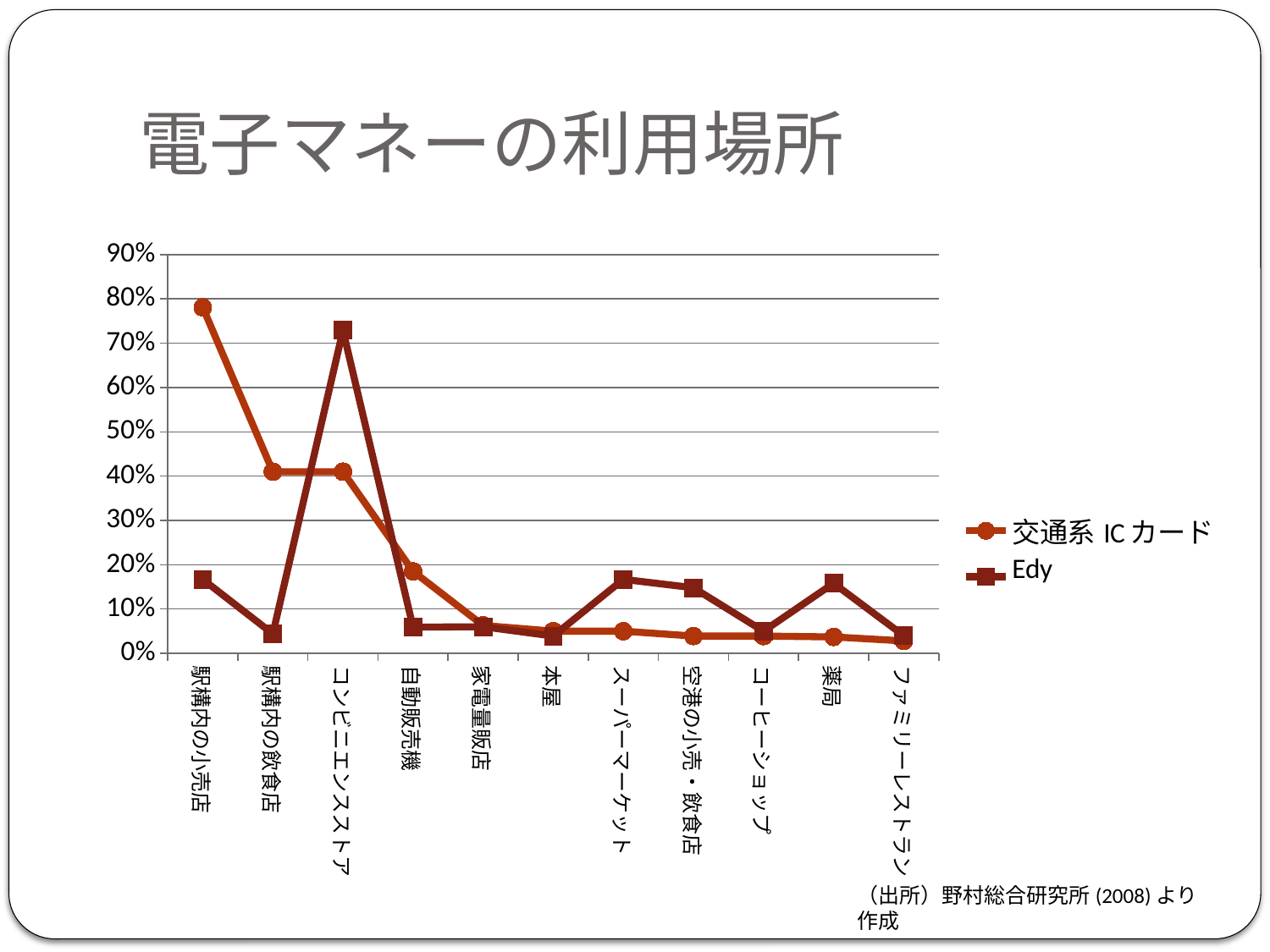
At コンビニエンスストア, which series has the larger value, 交通系 IC カード or Edy? Edy At 駅構内の小売店, which series has the larger value, 交通系 IC カード or Edy? 交通系 IC カード Is the value for 交通系 IC カード at 駅構内の小売店 greater or less than 70%? greater Is the value for Edy at コンビニエンスストア greater or less than 60%? greater For which category is the Edy series highest? コンビニエンスストア What is the title of the slide? 電子マネーの利用場所 How many series does the legend list? 2 Does the 交通系 IC カード series rise or fall from 駅構内の小売店 to 自動販売機? fall What kind of chart is shown on the slide? Line chart For which category is the 交通系 IC カード series highest? 駅構内の小売店 How many categories are shown on the x axis? 11 Is the value for 交通系 IC カード at 自動販売機 greater or less than 30%? less